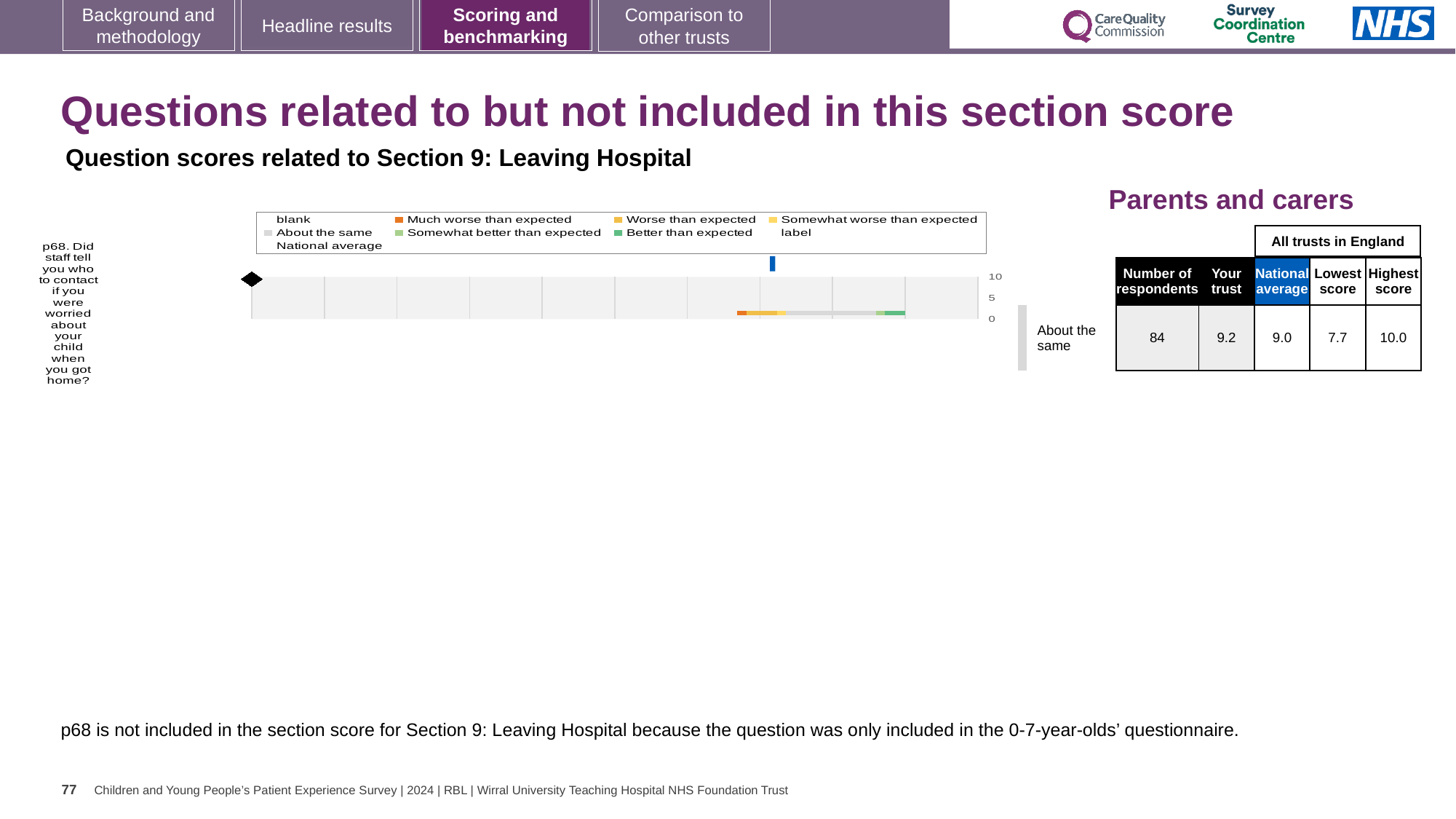
What is the difference between the highest and lowest trust scores for p68? 2.3 How many respondents answered p68? 84 What is the 'Your trust' score for p68? 9.2 What kind of chart is used to show the p68 question score? bar chart Which is higher for p68, the trust's score or the national average? Your trust Which benchmark category is the trust's p68 score placed in? About the same By how much does the trust's score for p68 exceed the national average? 0.2 How many questions are plotted in the chart? 1 What is the highest score among all trusts in England for p68? 10.0 What is the lowest score among all trusts in England for p68? 7.7 What is the national average score for p68? 9.0 What is the highest value shown on the chart's score axis? 10